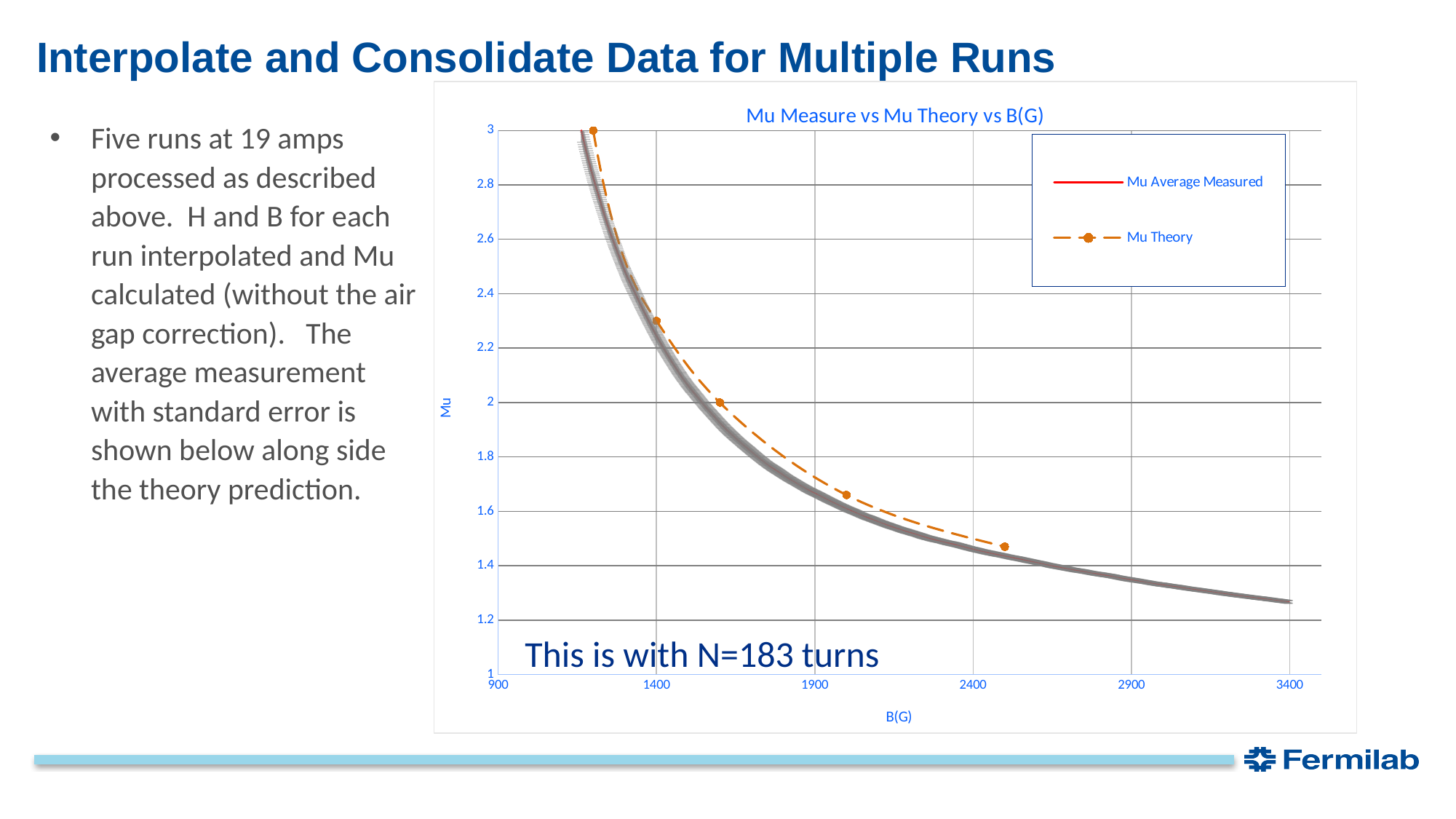
How many marked data points does the Mu Theory series have? 5 Is the Mu Average Measured value at B(G) = 3400 greater or less than 1.4? less Which series extends to the largest B(G) value on the chart? Mu Average Measured What is the label of the x axis? B(G) What kind of chart is shown on the slide? line chart Is the Mu Theory value at B(G) = 2400 greater or less than 1.4? greater Is the Mu Average Measured value at B(G) = 1400 greater or less than 2? greater Do the Mu values rise or fall as B(G) increases along the x axis? fall How many series does the chart legend list? 2 At B(G) = 1900, which series has the larger Mu value, Mu Theory or Mu Average Measured? Mu Theory What is the title of the chart? Mu Measure vs Mu Theory vs B(G) What is the highest Mu value reached by the Mu Theory series? 3